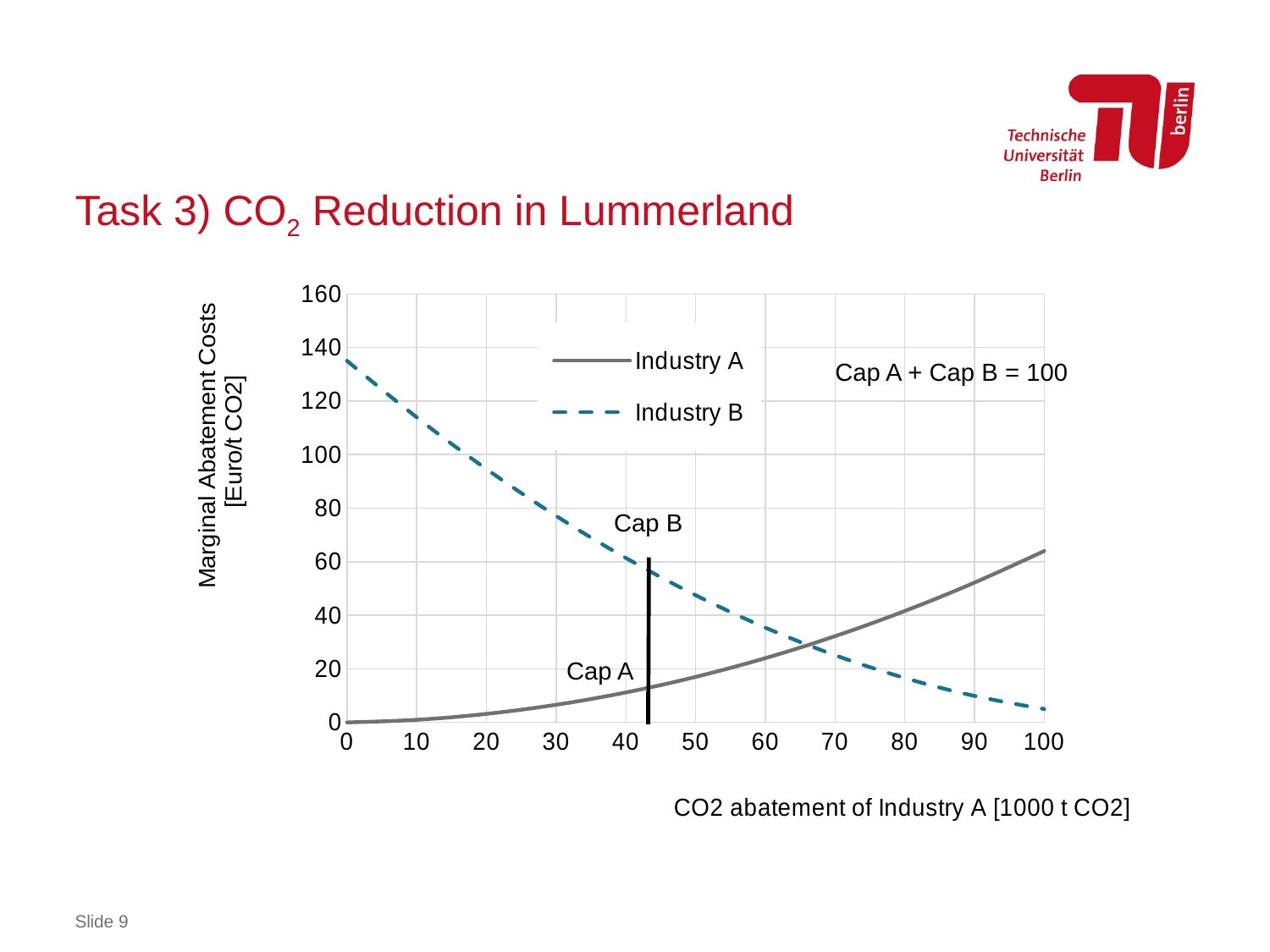
Is the value for Industry B at a CO2 abatement of 100 greater or less than 20? less At a CO2 abatement of 0, which series has the higher marginal abatement cost, Industry A or Industry B? Industry B Which two series are listed in the legend? Industry A and Industry B Is the value for Industry A at a CO2 abatement of 100 greater or less than 40? greater How many series does the legend list? 2 Do the values for Industry A rise or fall as CO2 abatement of Industry A increases along the x axis? Rise Is the value for Industry B at a CO2 abatement of 0 greater or less than 120? greater At a CO2 abatement of 100, which series has the higher marginal abatement cost, Industry A or Industry B? Industry A What kind of chart is shown on the slide? Line chart What is the title of the y axis of the chart? Marginal Abatement Costs [Euro/t CO2] Do the values for Industry B rise or fall as CO2 abatement of Industry A increases along the x axis? Fall